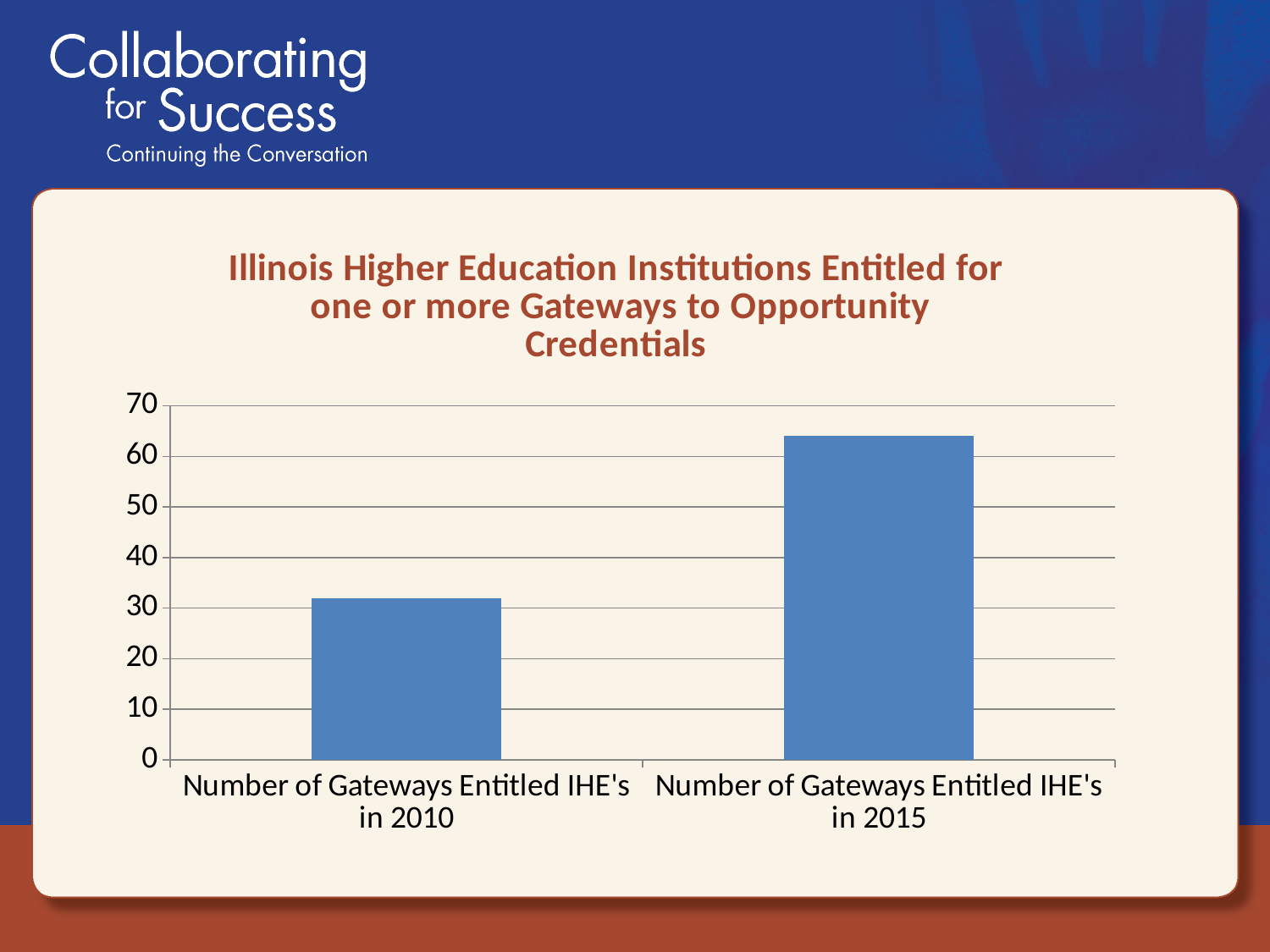
Which category has the higher value, Number of Gateways Entitled IHE's in 2010 or in 2015? Number of Gateways Entitled IHE's in 2015 What is the title of the chart? Illinois Higher Education Institutions Entitled for one or more Gateways to Opportunity Credentials Is the value for Number of Gateways Entitled IHE's in 2010 larger or smaller than the value for 2015? smaller Do the values rise or fall from 2010 to 2015 along the x axis? rise What is the highest value shown on the vertical axis? 70 How many bars does the chart show? 2 What kind of chart is shown on the slide? bar chart Is the value for Number of Gateways Entitled IHE's in 2015 greater or less than 60? greater Is the value for Number of Gateways Entitled IHE's in 2015 greater or less than 70? less Which category has the lowest value on the chart? Number of Gateways Entitled IHE's in 2010 Is the value for Number of Gateways Entitled IHE's in 2010 greater or less than 40? less